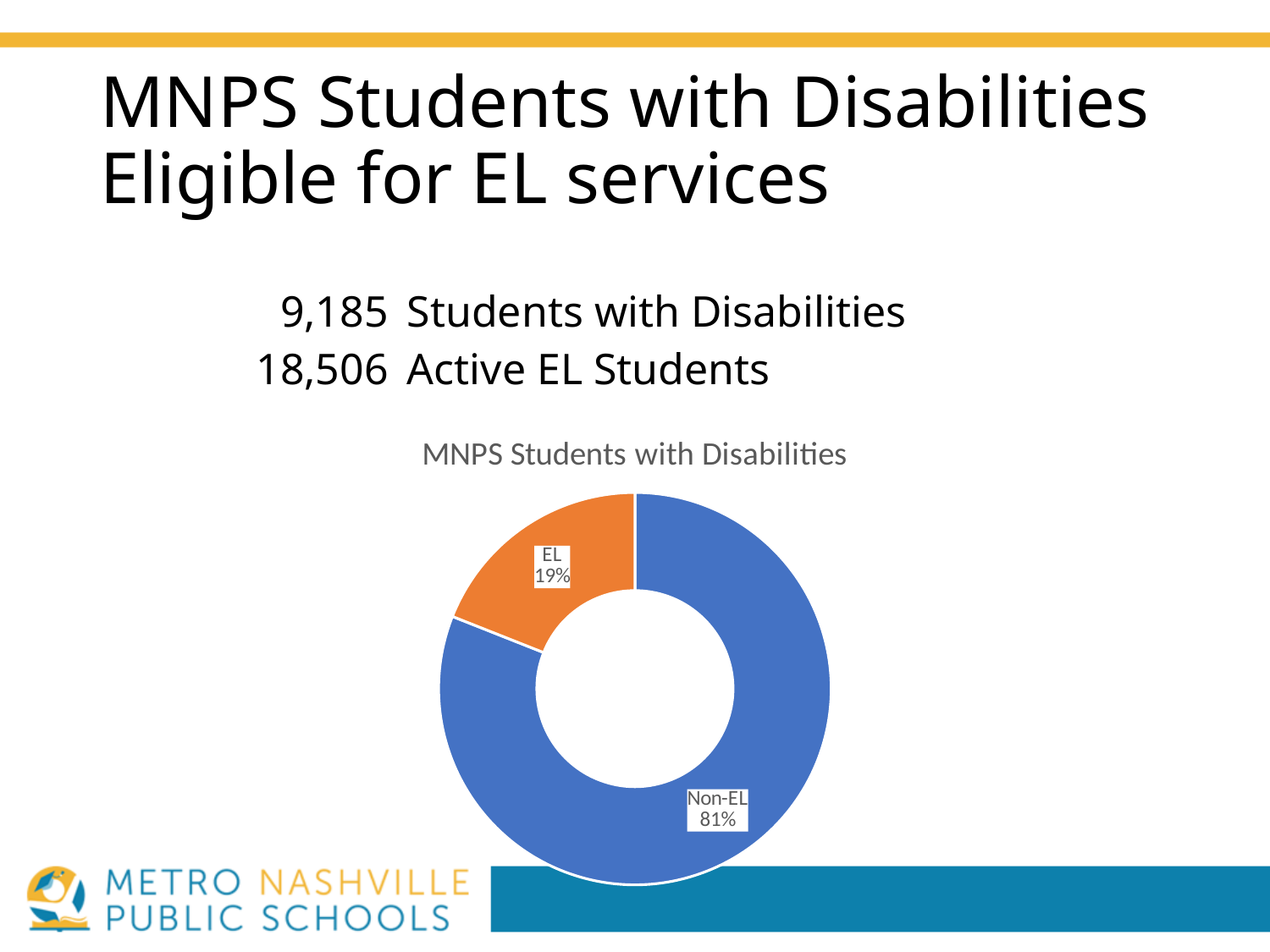
Which slice of the chart is the largest? Non-EL What is the difference in percentage points between the Non-EL and EL slices? 62 What kind of chart is shown on the slide? Doughnut (pie) chart What share of MNPS Students with Disabilities are Non-EL? 81% What share of MNPS Students with Disabilities are EL? 19% Is the Non-EL share greater or less than 50%? greater How many slices does the chart have? 2 What colour is the EL slice? Orange What is the title of the chart? MNPS Students with Disabilities Which is larger, the EL slice or the Non-EL slice? Non-EL Which slice of the chart is the smallest? EL